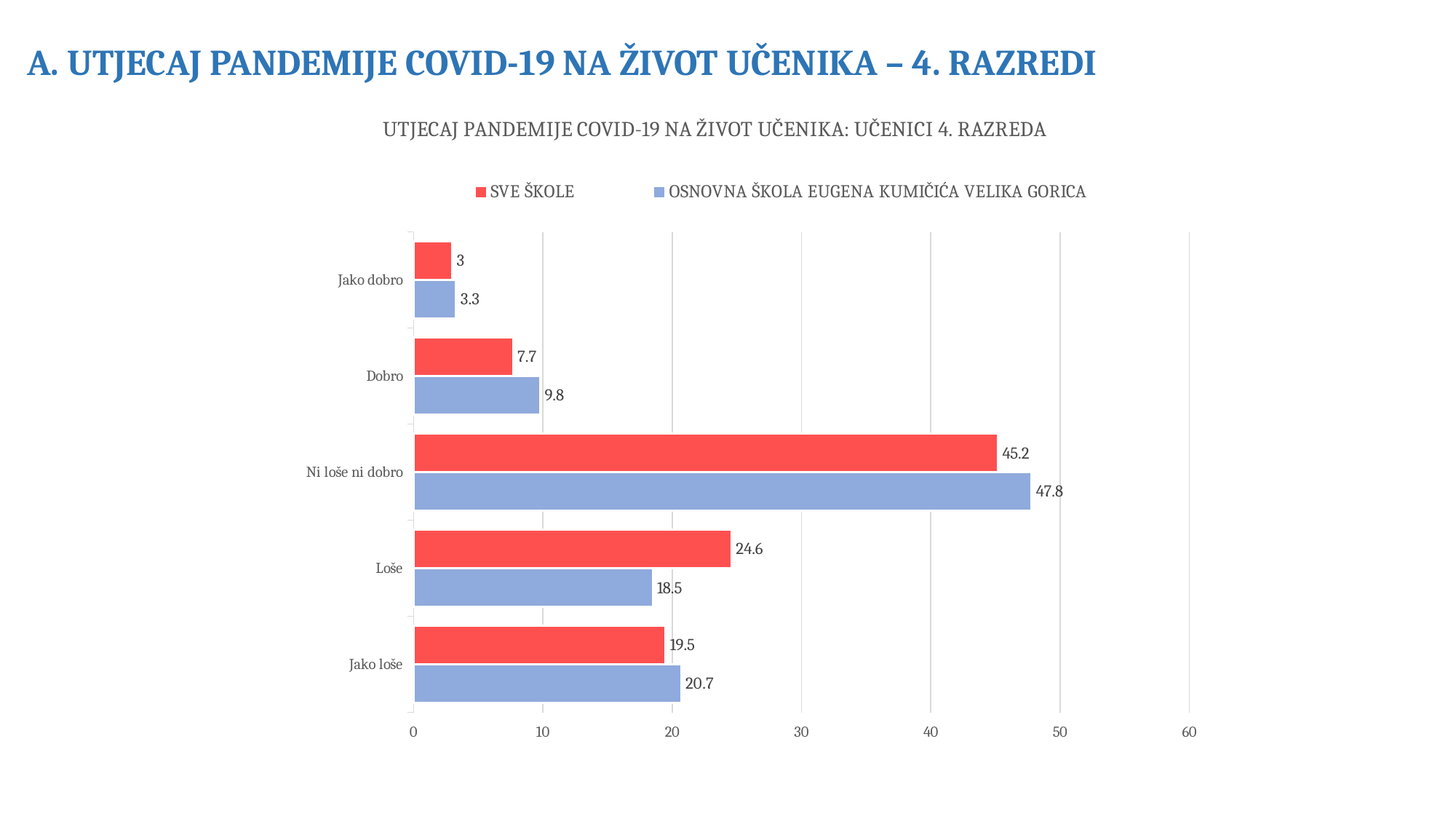
Which category has the highest value in the OSNOVNA ŠKOLA EUGENA KUMIČIĆA VELIKA GORICA series? Ni loše ni dobro What is the difference between the SVE ŠKOLE and OSNOVNA ŠKOLA EUGENA KUMIČIĆA VELIKA GORICA values for "Loše"? 6.1 What colour represents the SVE ŠKOLE series? Red Is the SVE ŠKOLE value for "Jako loše" greater or less than 20? less What is the value for "Ni loše ni dobro" in the SVE ŠKOLE series? 45.2 How many series does the legend list? 2 Which category has the lowest value in the SVE ŠKOLE series? Jako dobro What is the value for "Jako dobro" in the SVE ŠKOLE series? 3 What kind of chart is shown on the slide? Bar chart For "Dobro", which series has the larger value: SVE ŠKOLE or OSNOVNA ŠKOLA EUGENA KUMIČIĆA VELIKA GORICA? OSNOVNA ŠKOLA EUGENA KUMIČIĆA VELIKA GORICA What is the value for "Loše" in the OSNOVNA ŠKOLA EUGENA KUMIČIĆA VELIKA GORICA series? 18.5 How many categories are shown on the chart? 5